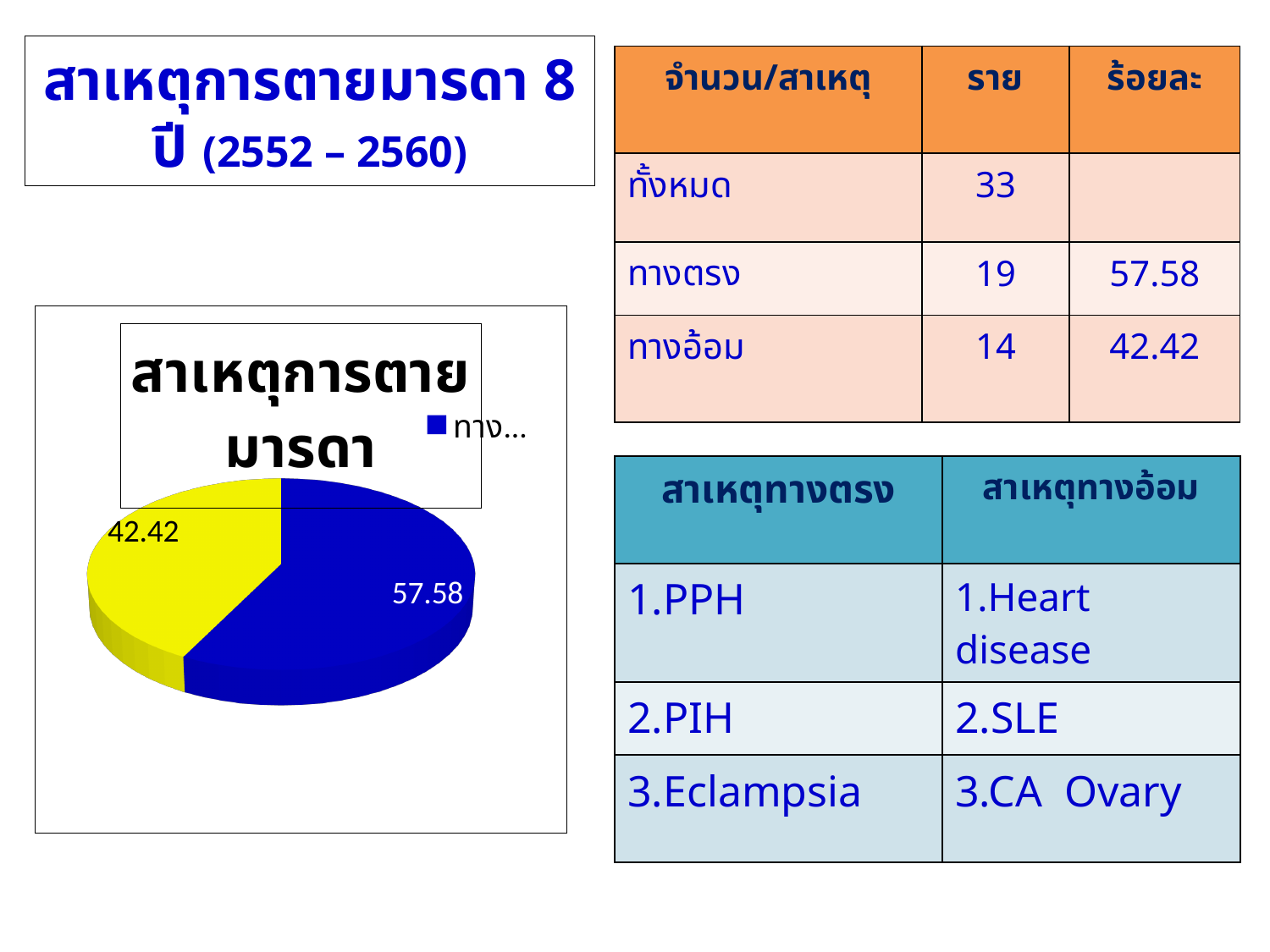
What kind of chart is shown on the left of the slide? pie chart What value is labelled on the yellow slice of the pie chart? 42.42 What value is labelled on the blue slice of the pie chart? 57.58 What colour is the slice labelled 42.42 in the pie chart? yellow What is the title of the pie chart? สาเหตุการตายมารดา How many slices does the pie chart have? 2 Which is larger in the pie chart, the blue slice or the yellow slice? the blue slice Which slice of the pie chart is the smallest? the yellow slice (42.42) What is the difference between the blue slice value and the yellow slice value in the pie chart? 15.16 Which slice of the pie chart is the largest? the blue slice (57.58) What do the two labelled slice values of the pie chart add up to? 100